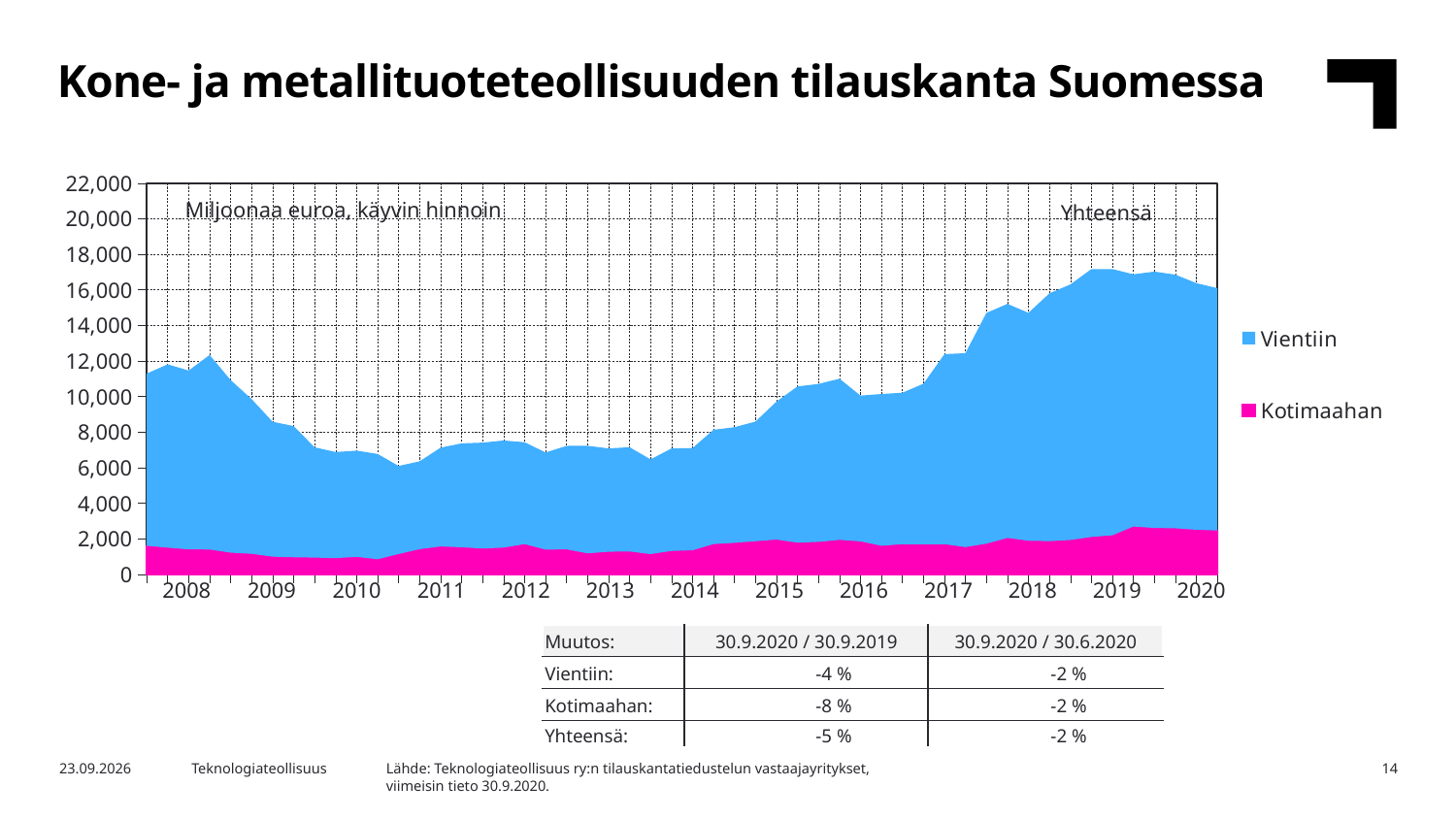
How many series does the chart legend list? 2 Is the Kotimaahan value in 2010 greater or less than 2,000? less What kind of chart is shown on the slide? Stacked area chart Is the Kotimaahan value in 2020 greater or less than 2,000? greater Which two series are listed in the chart legend? Vientiin and Kotimaahan Which is larger, the total order backlog in 2019 or in 2011? 2019 Is the total (Yhteensä) value at the start of 2008 greater or less than 10,000? greater What unit is stated on the chart? Miljoonaa euroa, käyvin hinnoin How many years are labelled on the x axis of the chart? 13 Does the total order backlog rise or fall between 2016 and 2019? rise